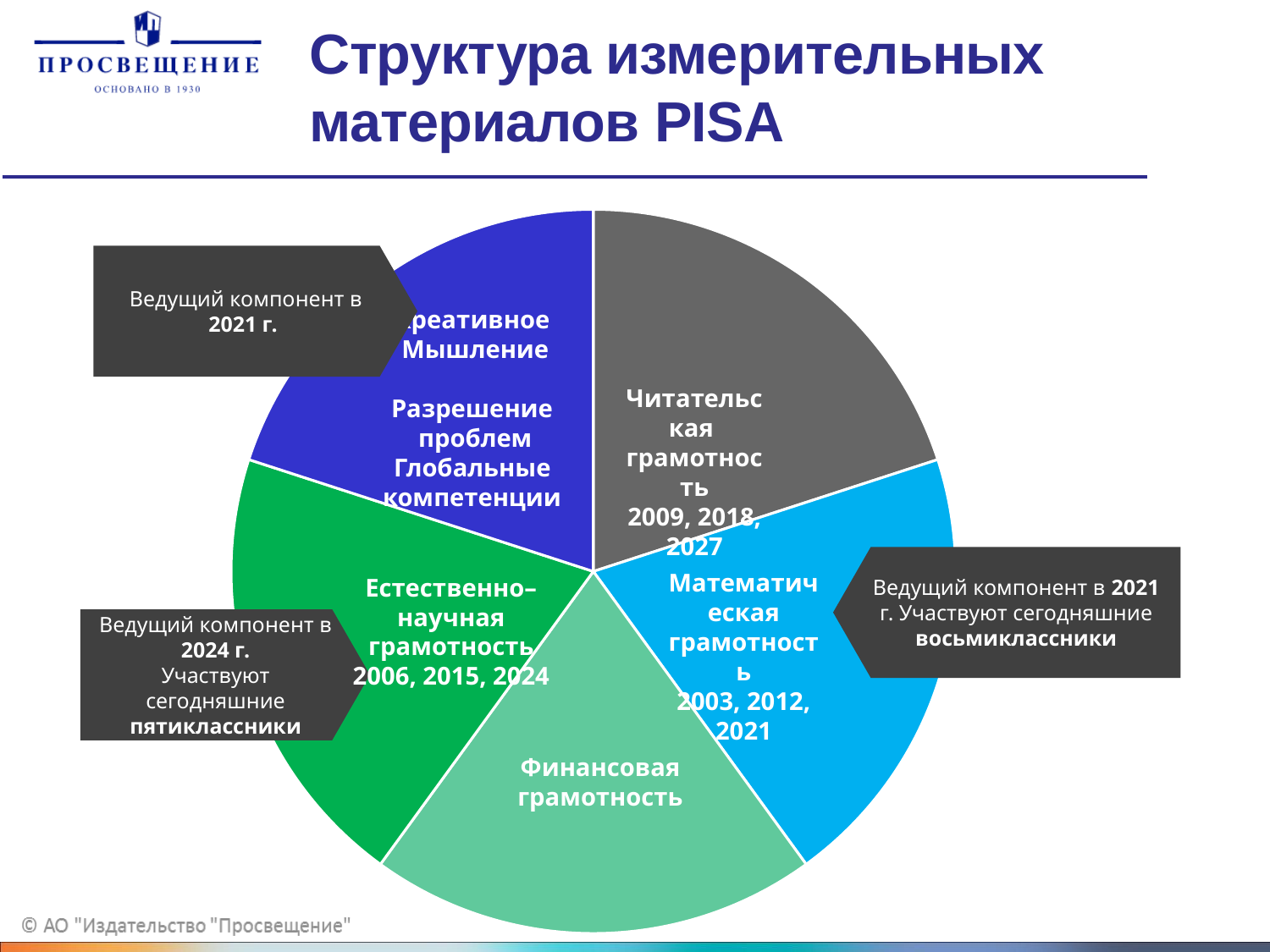
Which years are listed in the slice "Читательская грамотность"? 2009, 2018, 2027 Which years are listed in the slice "Математическая грамотность"? 2003, 2012, 2021 How many slices does the pie chart have? 5 What kind of chart is shown on the slide? pie chart What is the title of the slide containing the pie chart? Структура измерительных материалов PISA Which slice of the pie chart has no years listed in its label besides "Финансовая грамотность"? Креативное мышление / Разрешение проблем / Глобальные компетенции According to the callout, in which year is "Естественно-научная грамотность" the leading component? 2024 Which years are listed in the slice "Естественно-научная грамотность"? 2006, 2015, 2024 What colour is the slice labelled "Читательская грамотность"? grey According to the callout, in which year is "Математическая грамотность" the leading component? 2021